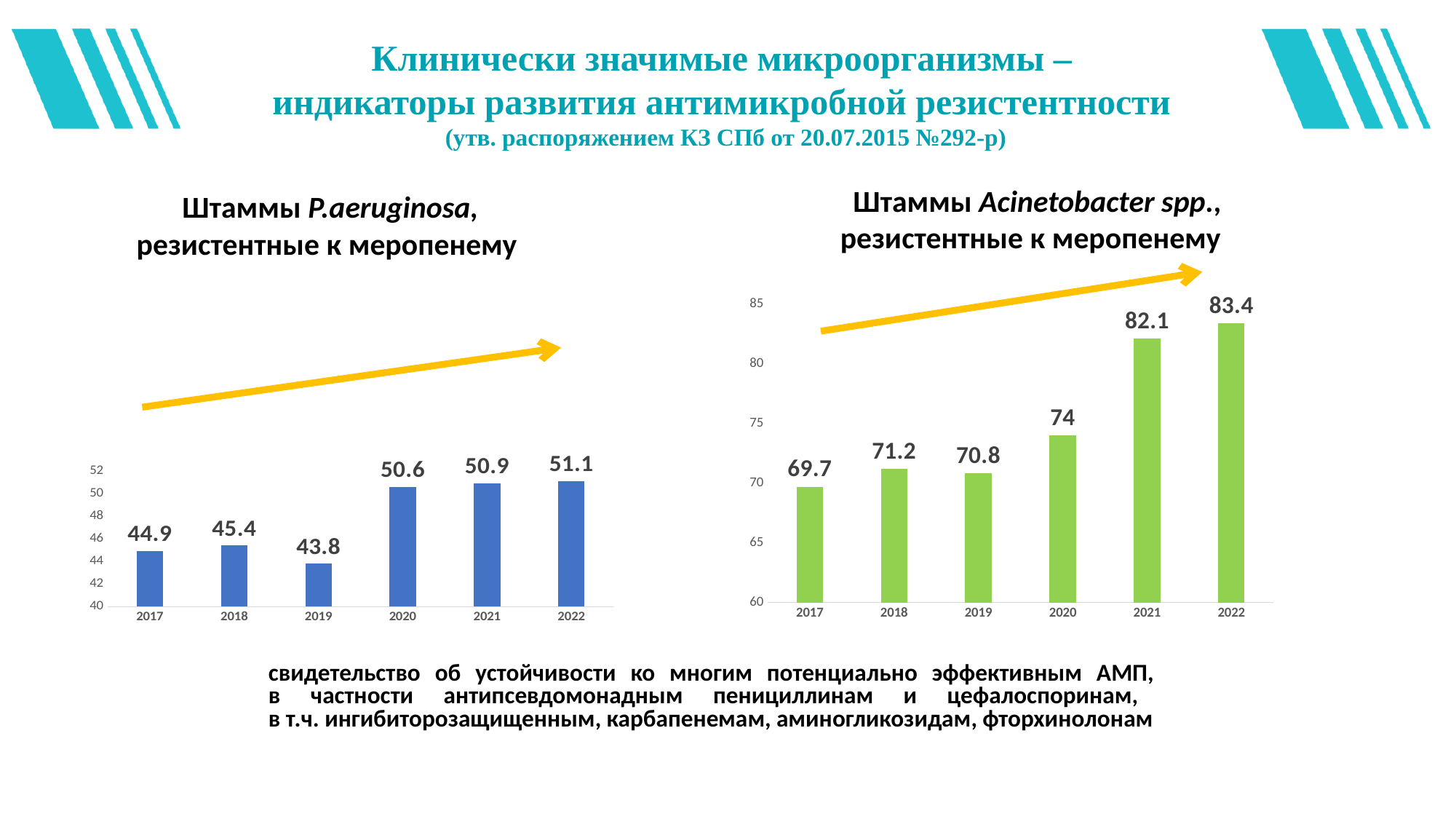
What kind of chart is the left chart (Штаммы P.aeruginosa)? bar chart In the left chart (Штаммы P.aeruginosa), what is the difference between the values for 2020 and 2019? 6.8 In the right chart (Штаммы Acinetobacter spp., резистентные к меропенему), what is the value for 2020? 74 In the left chart (Штаммы P.aeruginosa), which year has the highest value? 2022 In the left chart (Штаммы P.aeruginosa, резистентные к меропенему), what is the value for 2019? 43.8 In the right chart (Штаммы Acinetobacter spp.), which is larger, the value for 2018 or the value for 2019? 2018 How many years are shown on the x axis of the right chart (Штаммы Acinetobacter spp.)? 6 In the left chart (Штаммы P.aeruginosa), is the value for 2021 greater or less than 50? greater In the right chart (Штаммы Acinetobacter spp.), what is the difference between the values for 2022 and 2017? 13.7 In the left chart (Штаммы P.aeruginosa), which year has the lowest value? 2019 In the right chart (Штаммы Acinetobacter spp.), do the values generally rise or fall from 2017 to 2022? rise In the right chart (Штаммы Acinetobacter spp.), which year has the lowest value? 2017